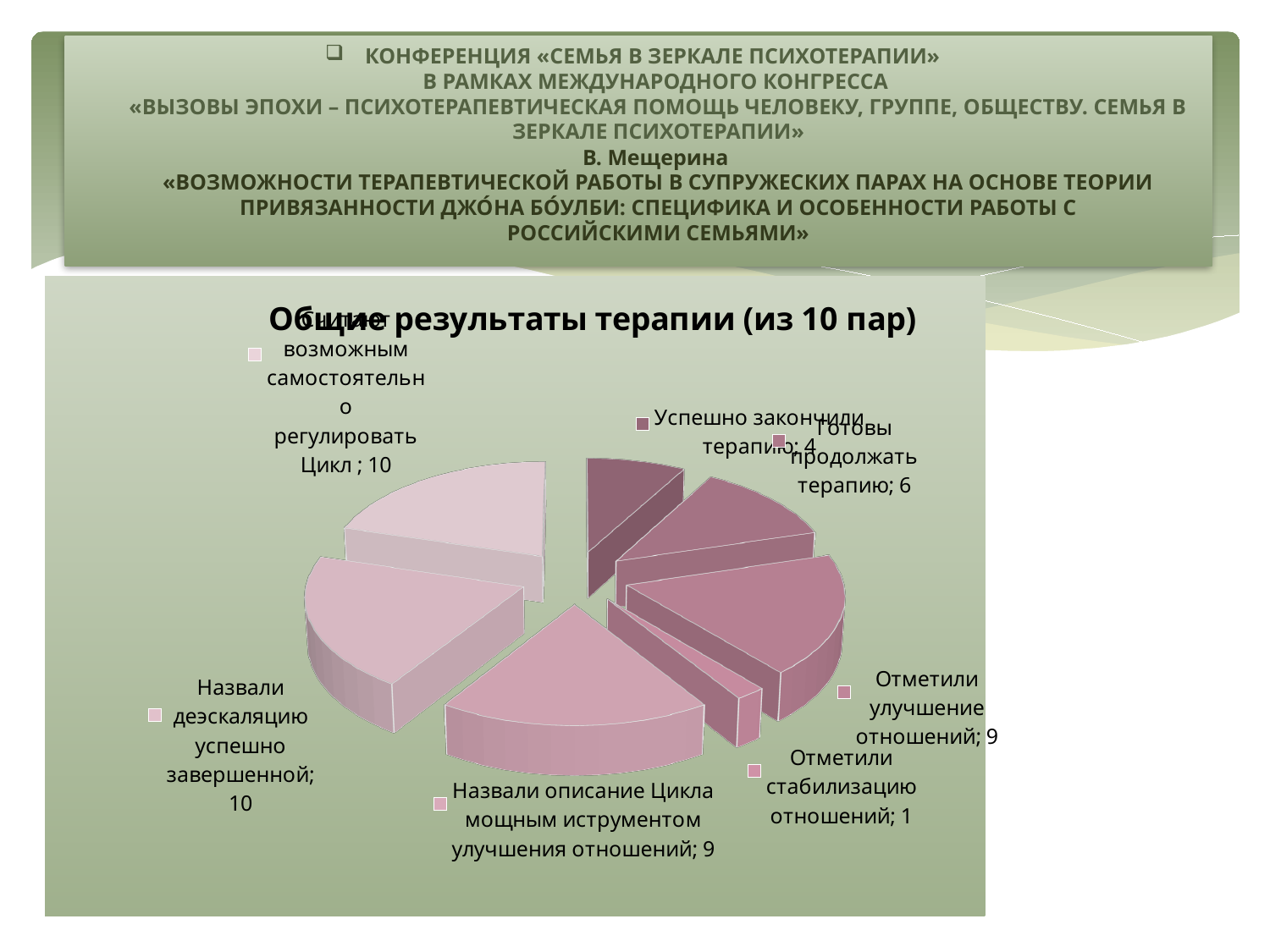
What is the value for "Назвали описание Цикла мощным иструментом улучшения отношений"? 9 What is the title of the chart? Общие результаты терапии (из 10 пар) What is the value for "Назвали деэскаляцию успешно завершенной"? 10 What is the difference between the values for "Отметили улучшение отношений" and "Отметили стабилизацию отношений"? 8 How many categories (slices) does the pie chart have? 7 What is the value for "Отметили стабилизацию отношений"? 1 Which category has the smallest value? Отметили стабилизацию отношений Which is larger: the value for "Готовы продолжать терапию" or for "Успешно закончили терапию"? Готовы продолжать терапию What is the value for "Готовы продолжать терапию"? 6 What is the value for "Отметили улучшение отношений"? 9 What is the value for "Успешно закончили терапию"? 4 What kind of chart is shown on the slide? pie chart